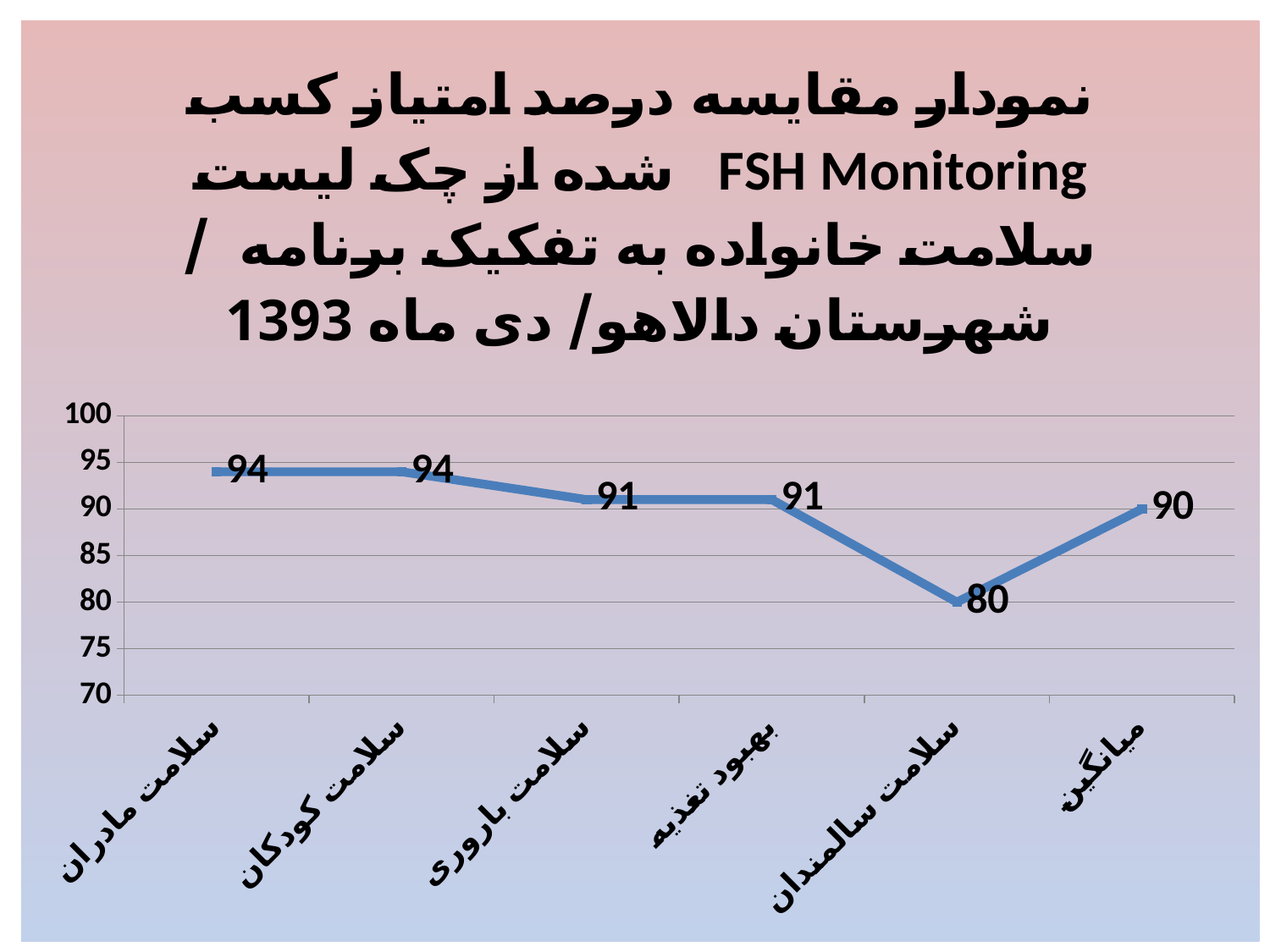
What is the value for میانگین? 90 What is the difference between the values for سلامت مادران and سلامت باروری? 3 What is the value for سلامت مادران? 94 Which is larger, the value for سلامت باروری or the value for میانگین? سلامت باروری What type of chart is shown on the slide? line chart Does the line rise or fall from سلامت سالمندان to میانگین? rise What is the difference between the values for سلامت کودکان and سلامت سالمندان? 14 Is the value for سلامت سالمندان greater or less than 85? less Which category has the lowest value? سلامت سالمندان What is the value for بهبود تغذیه? 91 How many categories are plotted on the x axis? 6 What is the value for سلامت سالمندان? 80